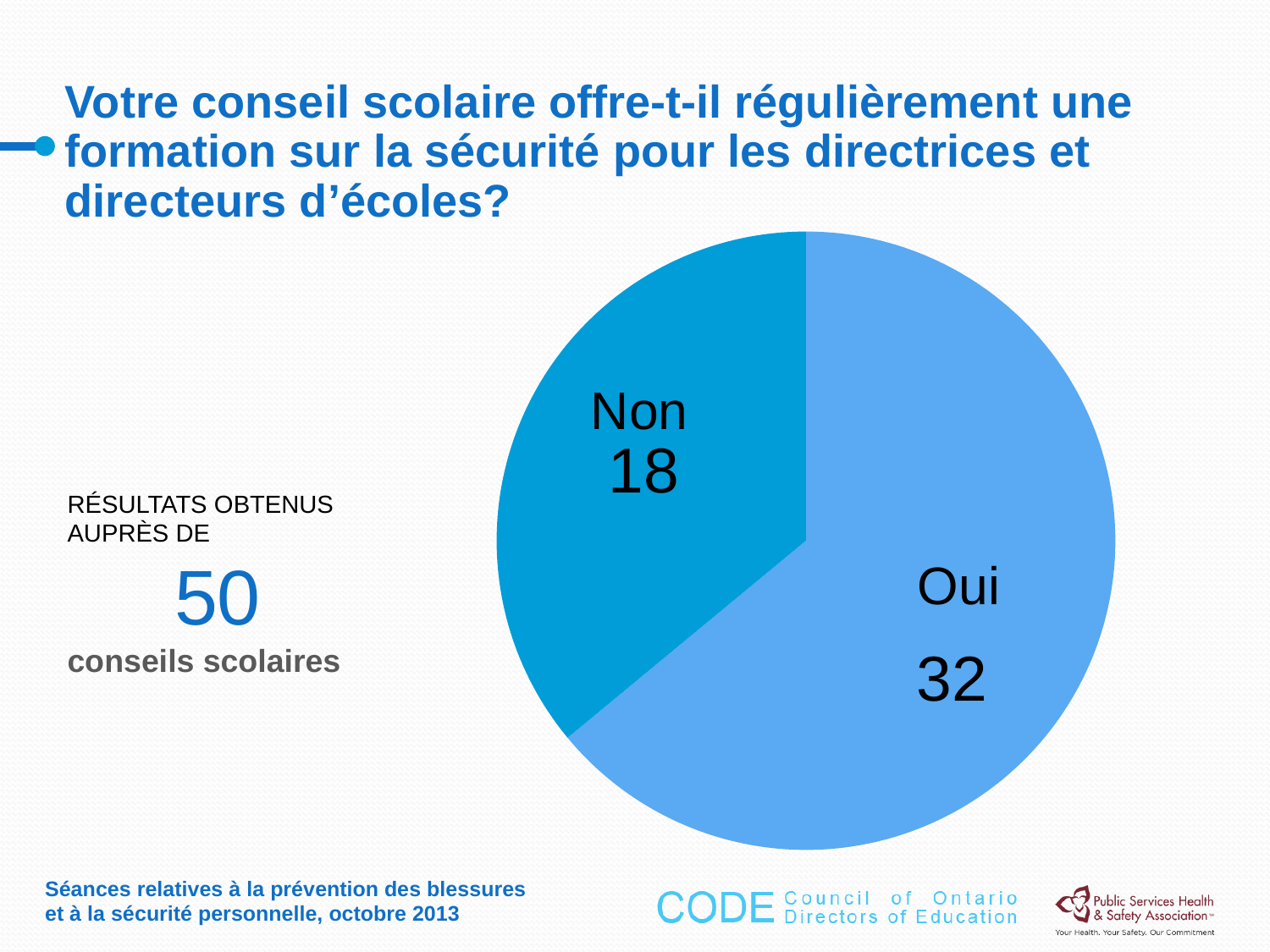
Which is larger, Oui or Non? Oui How many slices does the pie chart have? 2 What share of the pie does the Non slice represent? 36% What is the value for Oui? 32 Which slice is the smallest? Non What is the difference between the Oui and Non values? 14 Which slice is the largest? Oui What share of the pie does the Oui slice represent? 64% What is the total of the two slices? 50 How many school boards (conseils scolaires) do the results come from, according to the slide? 50 What kind of chart is shown on the slide? pie chart What is the value for Non? 18